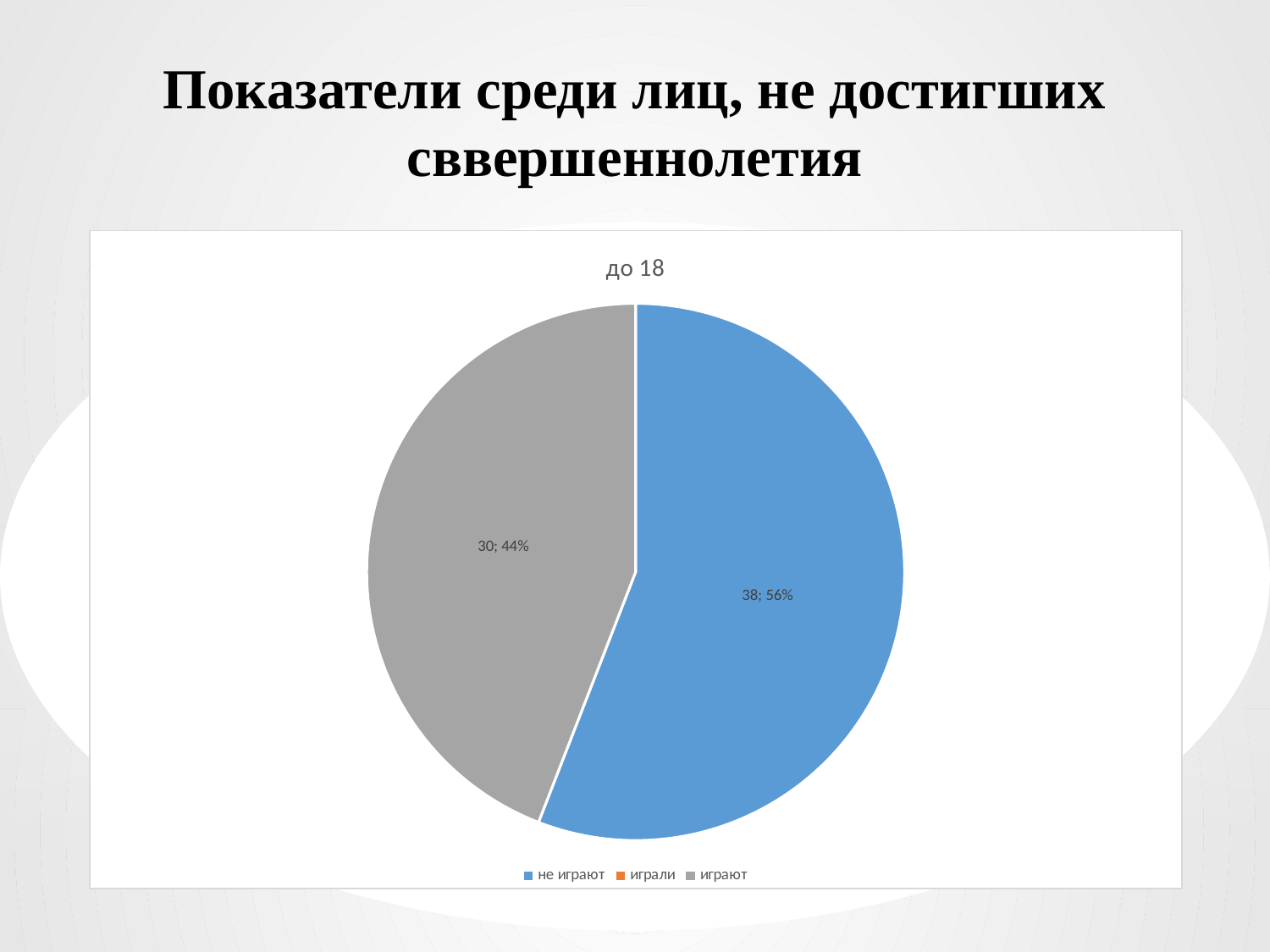
What share of the pie does "не играют" take? 56% What colour is the slice for "не играют"? blue What is the title of the chart? до 18 What is the value for "не играют"? 38 What is the value for "играют"? 30 What is the difference between the values for "не играют" and "играют"? 8 What kind of chart is shown on the slide? pie chart How many entries does the chart legend list? 3 Which of the two visible slices is larger, "не играют" or "играют"? не играют What share of the pie does "играют" take? 44% What is the total of the values shown on the pie slices? 68 Which category has the largest slice of the pie? не играют